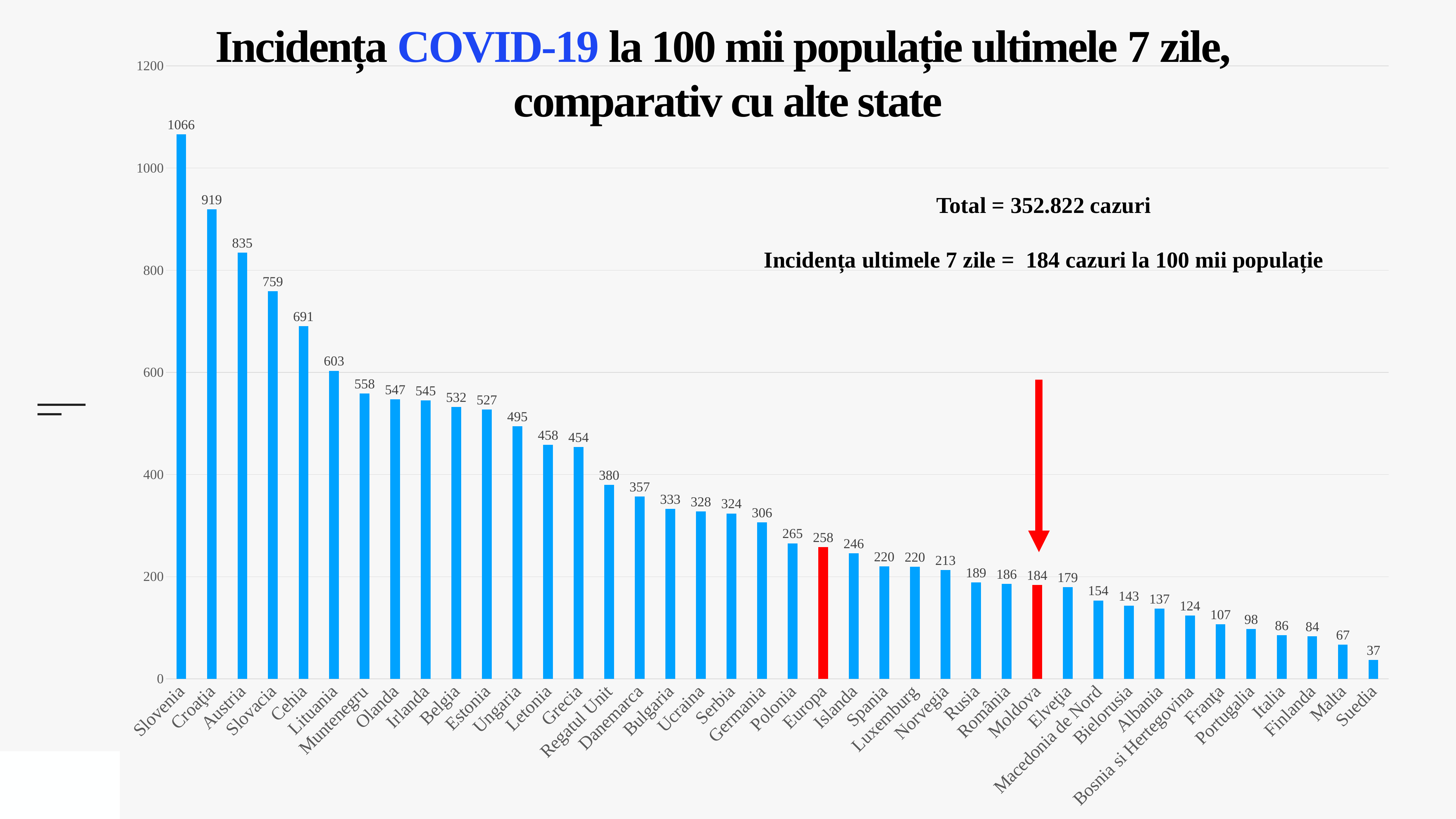
How many countries/categories are shown on the chart? 40 What is the value for Slovacia? 759 What kind of chart is shown on the slide? Bar chart Which country has the highest value? Slovenia What is the value for Moldova? 184 Is the value for Lituania greater or less than 600? greater What is the difference between the values for Slovenia and Croația? 147 Which has a larger value, Germania or Polonia? Germania What is the difference between the values for Europa and Moldova? 74 What is the value for Europa? 258 Which country has the lowest value? Suedia Which two bars are coloured red instead of blue? Europa and Moldova